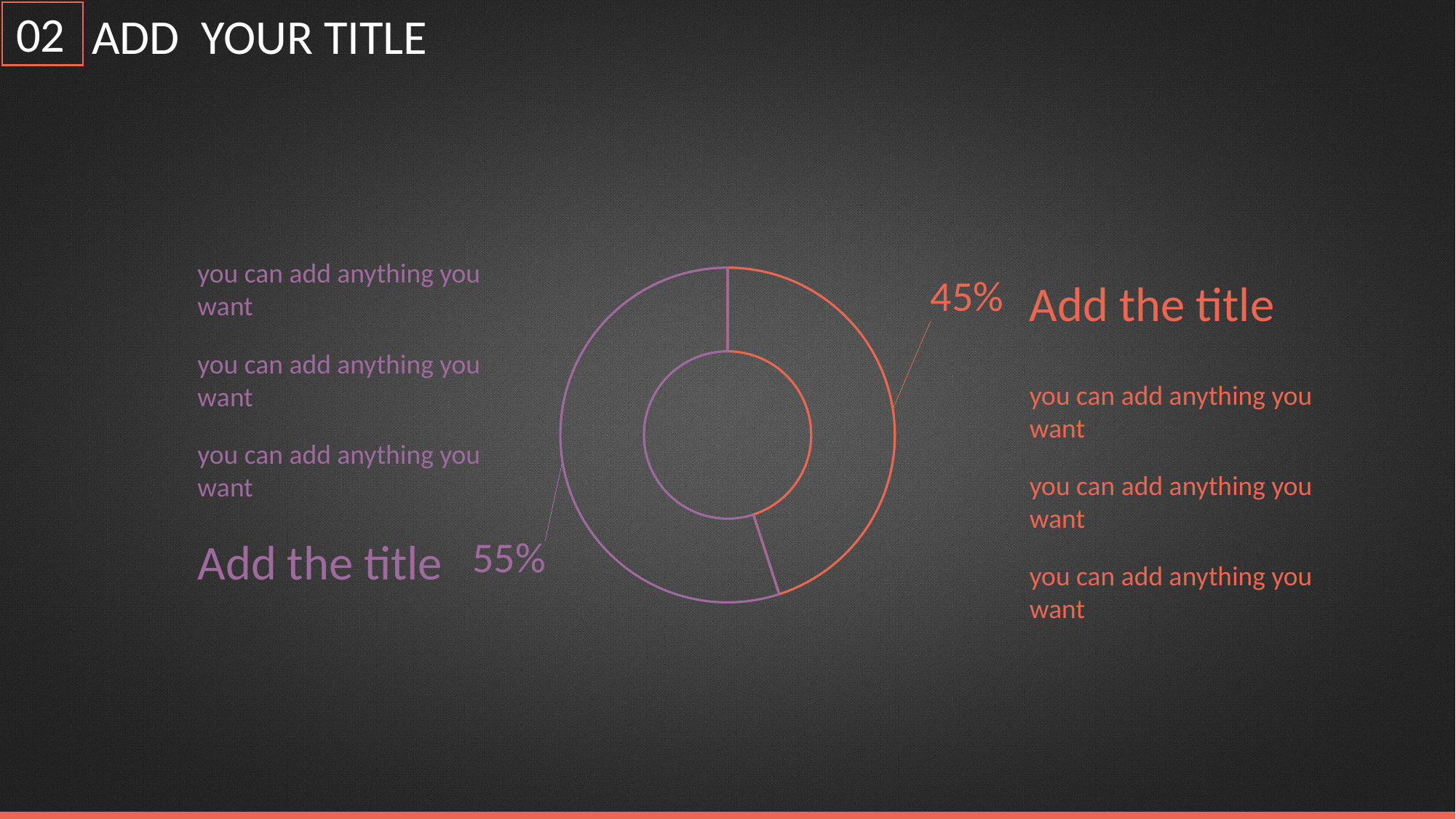
Is the value for the orange segment greater or less than 50%? less What is the slide title shown at the top? ADD YOUR TITLE What percentage is shown for the orange segment of the doughnut chart? 45% Which segment of the doughnut chart is the smallest? the orange segment (45%) Which segment of the doughnut chart is the largest? the purple segment (55%) What is the total of the two percentages shown on the doughnut chart? 100% What percentage is shown for the purple segment of the doughnut chart? 55% What colour is the segment labelled 55%? purple What kind of chart is shown on the slide? doughnut chart How many segments does the doughnut chart have? 2 What is the difference in percentage points between the purple segment and the orange segment? 10 Is the purple segment or the orange segment larger? the purple segment